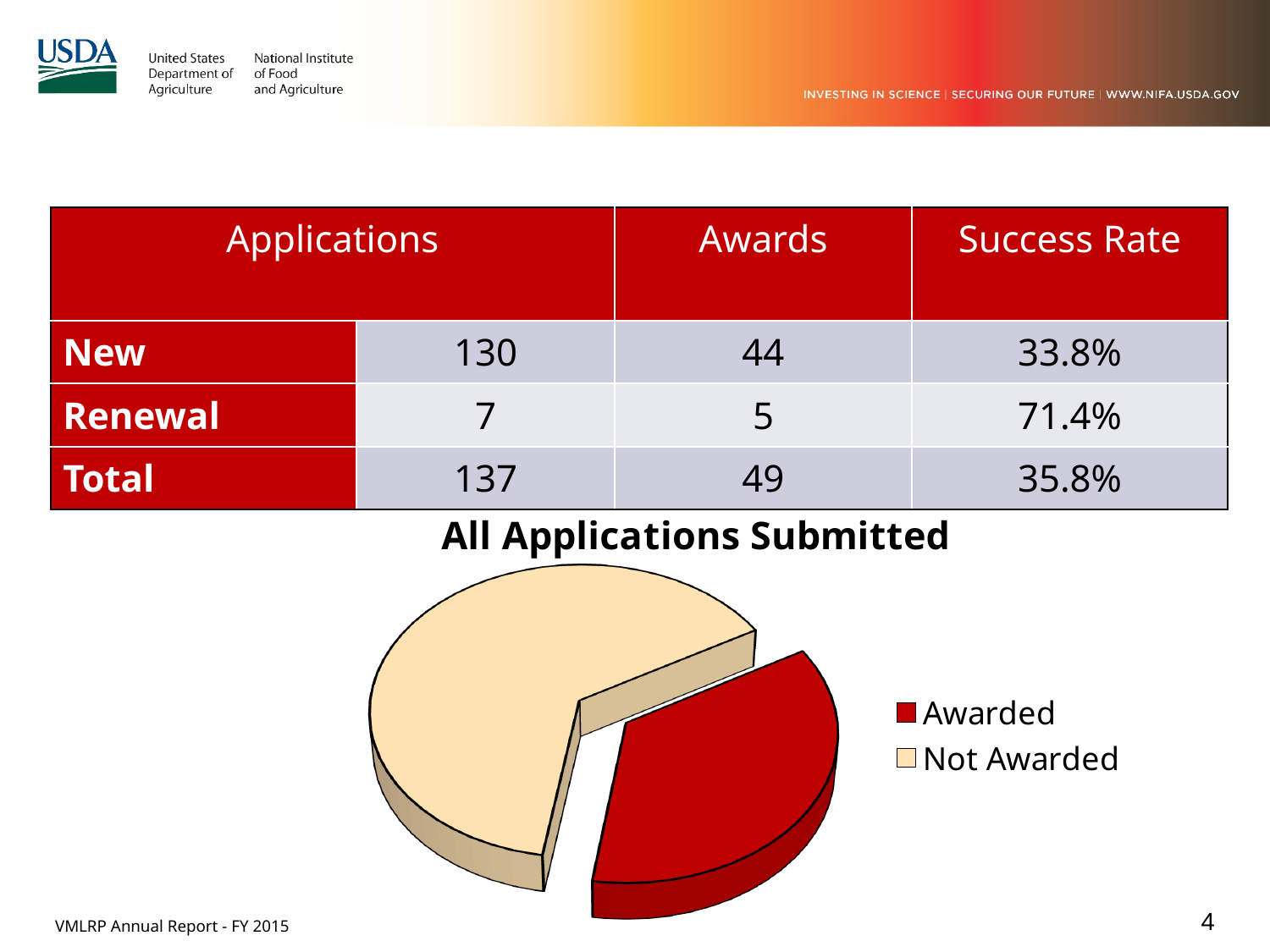
What colour is the Awarded slice in the pie chart? red In the pie chart, which is larger: the Awarded slice or the Not Awarded slice? Not Awarded How many slices does the pie chart have? 2 How many entries does the legend of the pie chart list? 2 What kind of chart is shown on the slide? pie chart Which slice of the pie chart is the smallest? Awarded Which slice of the pie chart is the largest? Not Awarded What is the title of the pie chart? All Applications Submitted